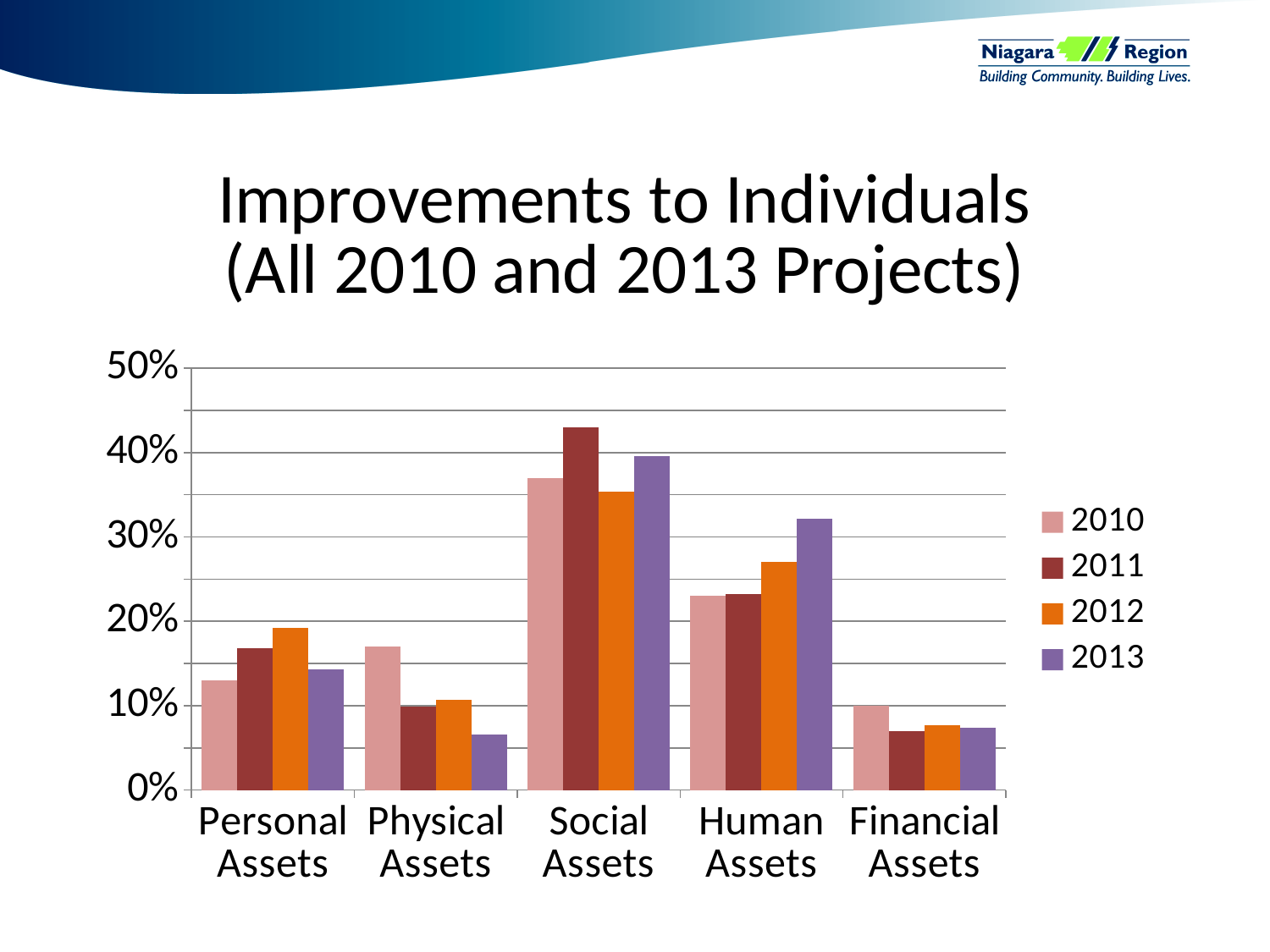
Within Social Assets, which year has the tallest bar? 2011 What kind of chart is shown on the slide? bar chart Which is larger for Human Assets: the 2010 value or the 2013 value? 2013 How many series does the legend list? 4 How many categories are shown on the x axis? 5 Which is larger for Physical Assets: the 2010 value or the 2013 value? 2010 Which category has the highest value for 2013? Social Assets Which category has the lowest value for 2011? Financial Assets Is the value for Physical Assets in 2013 greater or less than 10%? less What is the title of the chart on the slide? Improvements to Individuals (All 2010 and 2013 Projects) Is the value for Social Assets in 2011 greater or less than 40%? greater Is the value for Human Assets in 2013 greater or less than 30%? greater